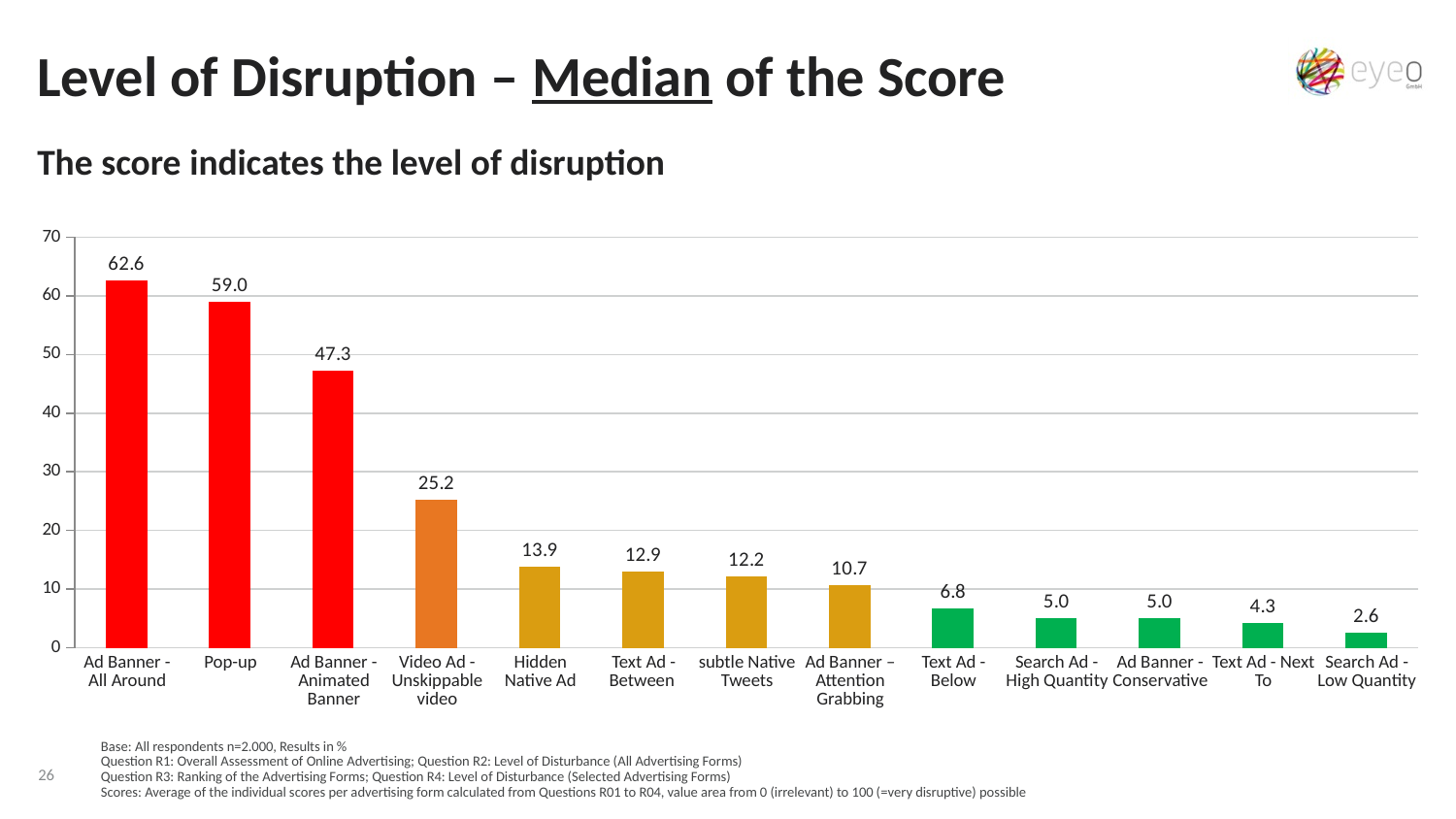
Which advertising form has the lowest median disruption score? Search Ad - Low Quantity How many advertising forms are shown on the chart? 13 Is the score for Ad Banner – Attention Grabbing greater or less than 20? less Which has a higher score, Ad Banner - Animated Banner or Video Ad - Unskippable video? Ad Banner - Animated Banner Do the scores rise or fall from left to right across the chart? fall What is the median disruption score for Video Ad - Unskippable video? 25.2 What kind of chart is shown on the slide? bar chart Which advertising form has the highest median disruption score? Ad Banner - All Around What is the difference between the scores for Text Ad - Between and Text Ad - Below? 6.1 What is the difference between the scores for Ad Banner - All Around and Pop-up? 3.6 What is the median disruption score for Pop-up? 59.0 What is the median disruption score for Hidden Native Ad? 13.9